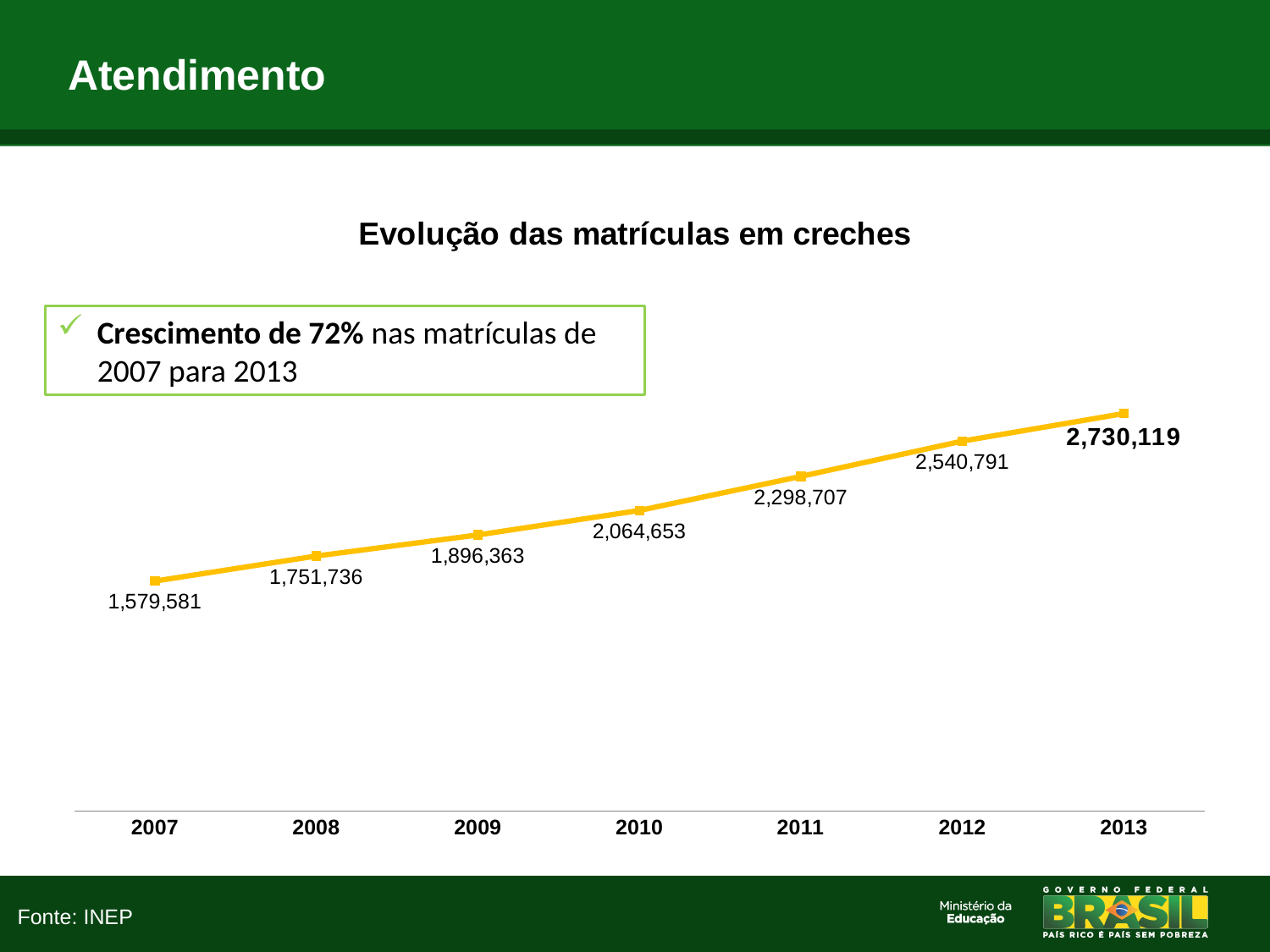
Which year has the highest value in the chart? 2013 What is the value for 2007 in the chart? 1,579,581 What is the value for 2011 in the chart? 2,298,707 What is the difference between the values for 2013 and 2007? 1,150,538 Do the values rise or fall from 2007 to 2013? Rise Which is larger, the value for 2009 or the value for 2012? 2012 What is the value for 2010 in the chart? 2,064,653 How many years are plotted in the chart? 7 What is the value for 2013 in the chart? 2,730,119 What kind of chart is shown on the slide? Line chart What is the difference between the values for 2012 and 2011? 242,084 Which year has the lowest value in the chart? 2007